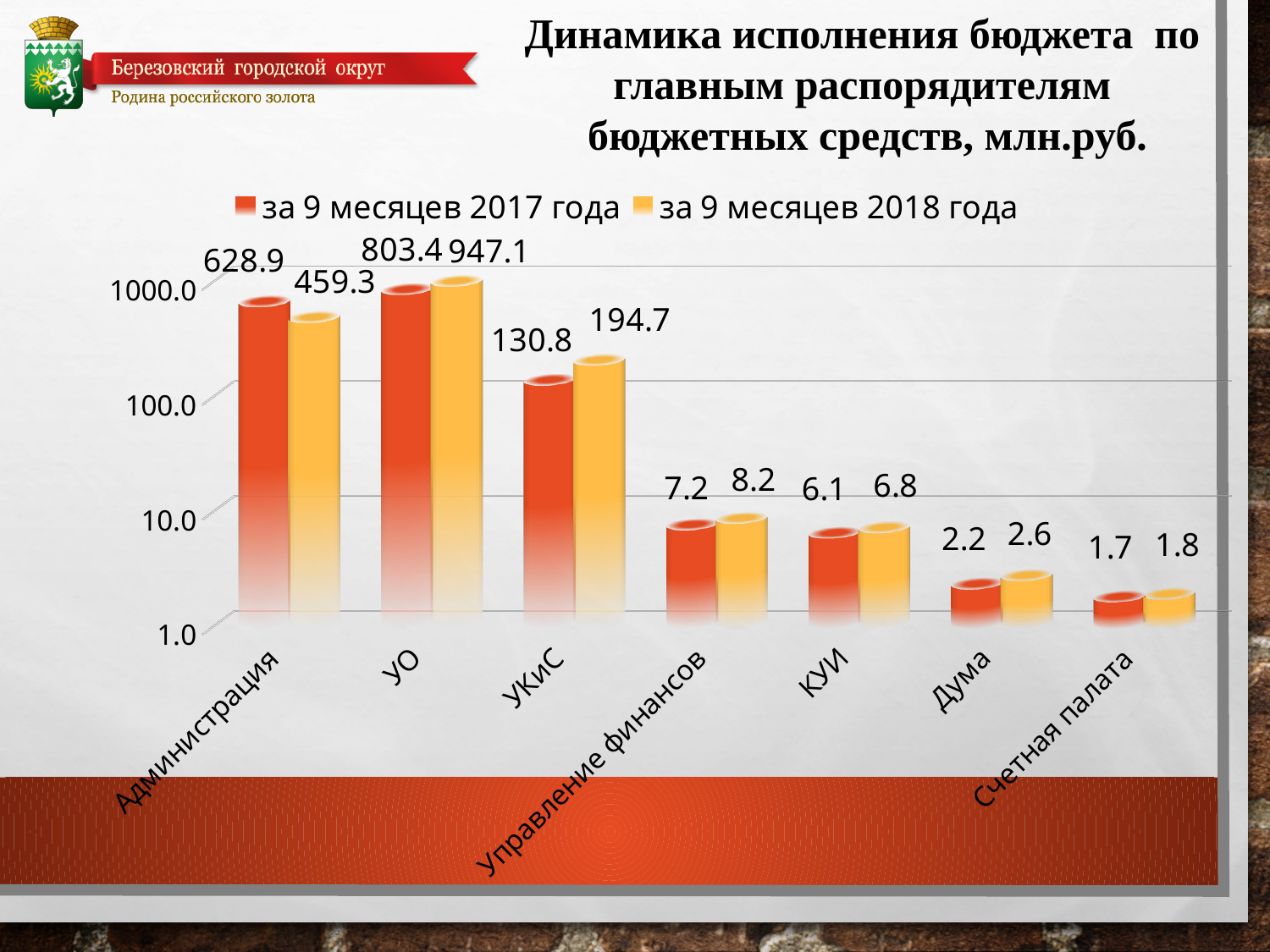
Which colour represents за 9 месяцев 2018 года in the legend? Yellow How many categories are shown on the x axis? 7 What is the value for УКиС for за 9 месяцев 2018 года? 194.7 How many series does the legend list? 2 What is the value for Администрация for за 9 месяцев 2017 года? 628.9 What is the value for УО for за 9 месяцев 2018 года? 947.1 What kind of chart is shown on the slide? Bar chart What is the difference between the 2018 and 2017 values for УКиС? 63.9 What is the value for Счетная палата for за 9 месяцев 2017 года? 1.7 Which category has the highest value for за 9 месяцев 2018 года? УО Which category has the lowest value for за 9 месяцев 2017 года? Счетная палата For Администрация, which is larger: the value for за 9 месяцев 2017 года or за 9 месяцев 2018 года? за 9 месяцев 2017 года